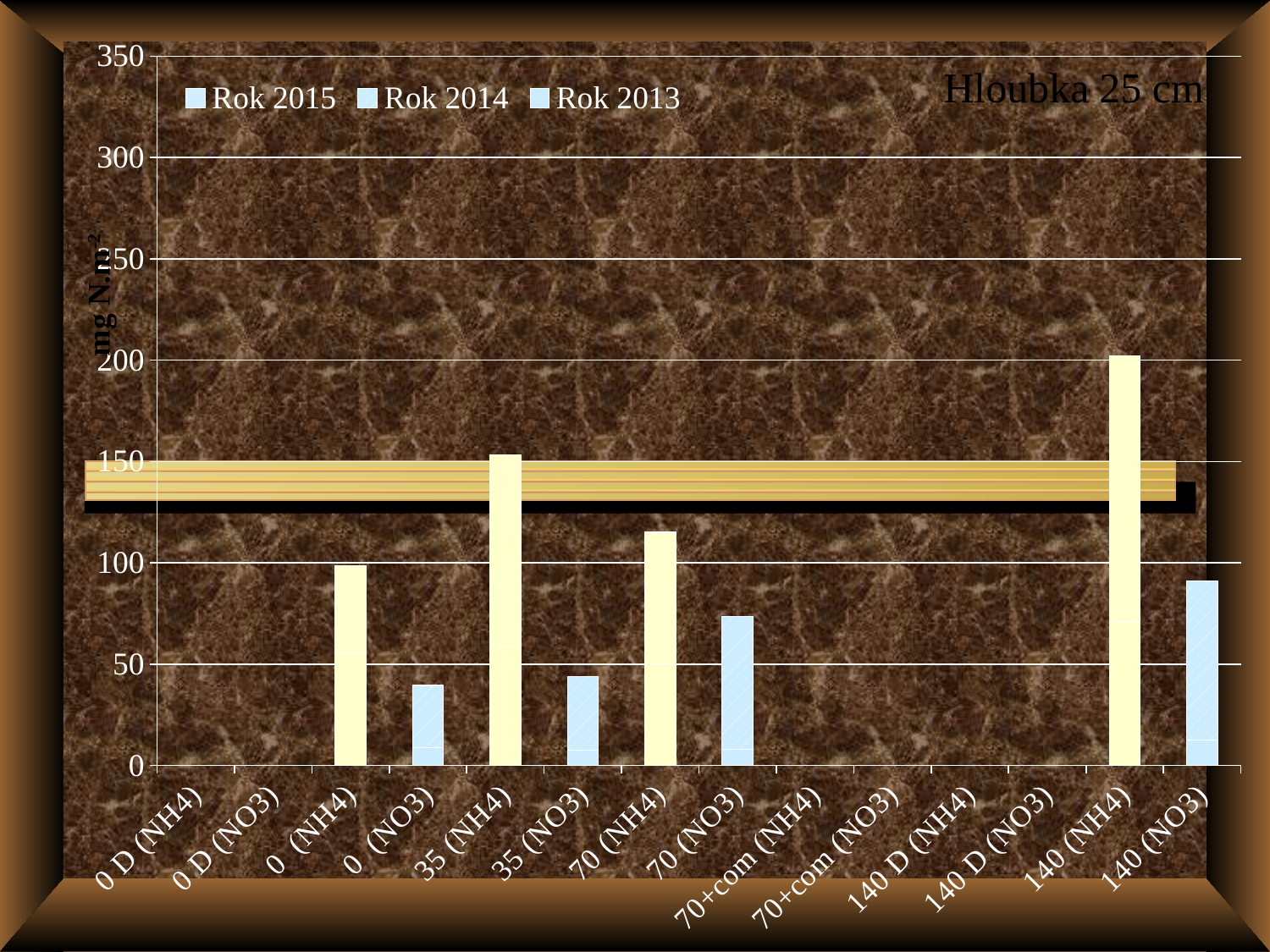
What kind of chart is shown on the slide? bar chart Which category has the tallest bar? 140 (NH4) Is the value for 0 (NO3) greater or less than 50? less Is the value for 140 (NH4) greater or less than 150? greater How many series does the legend list? 3 Is the value for 140 (NO3) greater or less than 100? less What is the title shown on the chart? Hloubka 25 cm Which is larger, the value for 35 (NH4) or the value for 140 (NH4)? 140 (NH4) Which is larger, the value for 70 (NH4) or the value for 70 (NO3)? 70 (NH4) What is the label of the y axis? mg N.m² How many categories are shown on the x axis? 14